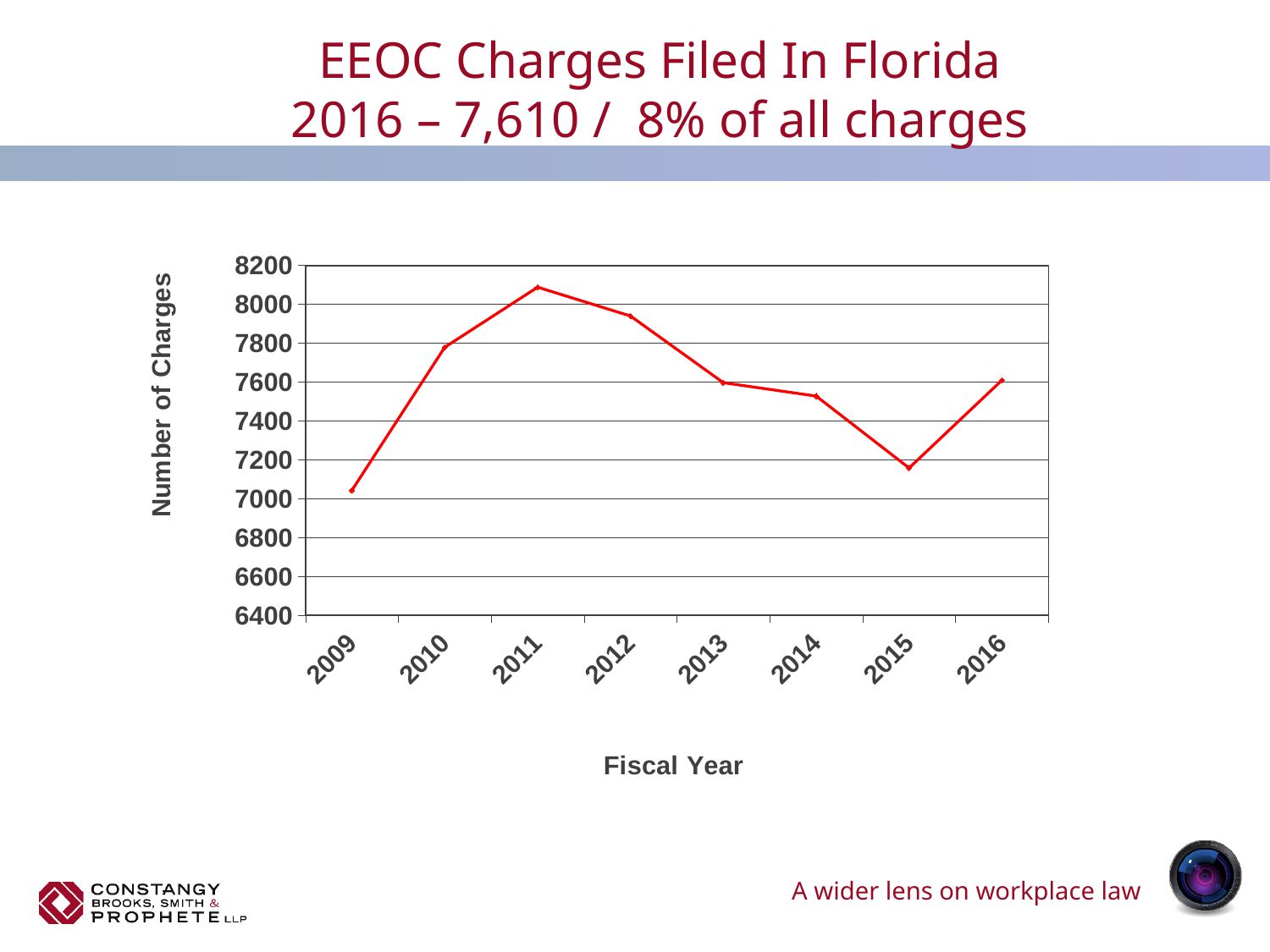
How many fiscal years are plotted on the chart? 8 Is the value for 2015 greater or less than 7400? less What kind of chart is shown on the slide? line chart How many EEOC charges were filed in Florida in 2016, according to the slide? 7,610 What is the label on the vertical axis? Number of Charges Do the values rise or fall from 2011 to 2015? fall Is the value for 2009 greater or less than 7200? less Which fiscal year has the lowest number of charges? 2009 What is the label on the horizontal axis? Fiscal Year Which fiscal year has the highest number of charges? 2011 Is the value for 2011 greater or less than 8000? greater Which year has more charges, 2010 or 2014? 2010